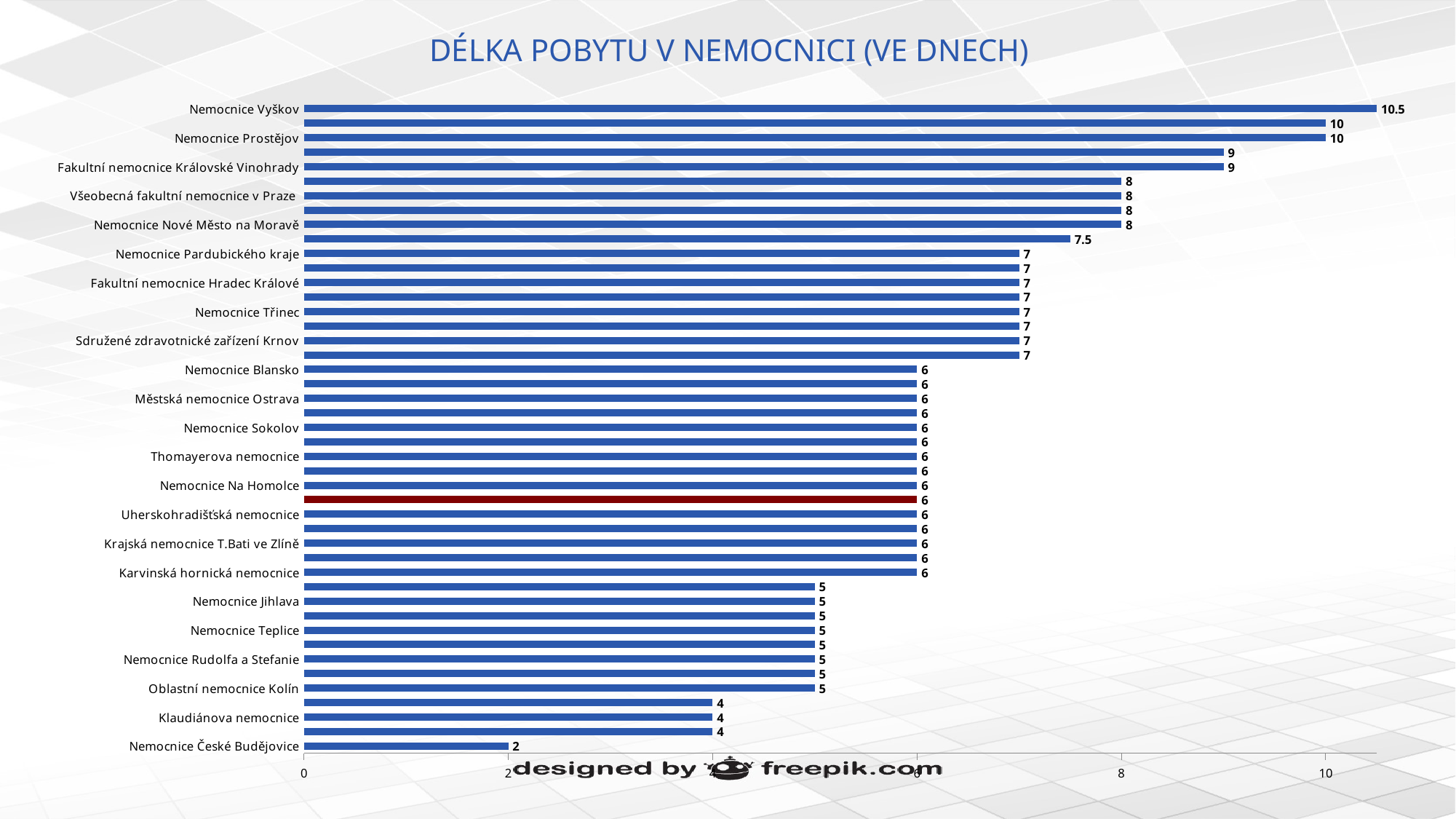
What kind of chart is shown on the slide? Bar chart Is the value for Nemocnice Třinec greater or less than 6? greater Which hospital has the lowest value? Nemocnice České Budějovice What is the value for Nemocnice České Budějovice? 2 What is the value for Nemocnice Vyškov? 10.5 What is the value of the bar highlighted in dark red? 6 What is the difference between the values for Nemocnice Vyškov and Nemocnice České Budějovice? 8.5 What is the value for Nemocnice Jihlava? 5 Which is larger, the value for Nemocnice Prostějov or the value for Nemocnice Blansko? Nemocnice Prostějov What is the value for Klaudiánova nemocnice? 4 What is the value for Fakultní nemocnice Královské Vinohrady? 9 Which hospital has the highest value? Nemocnice Vyškov